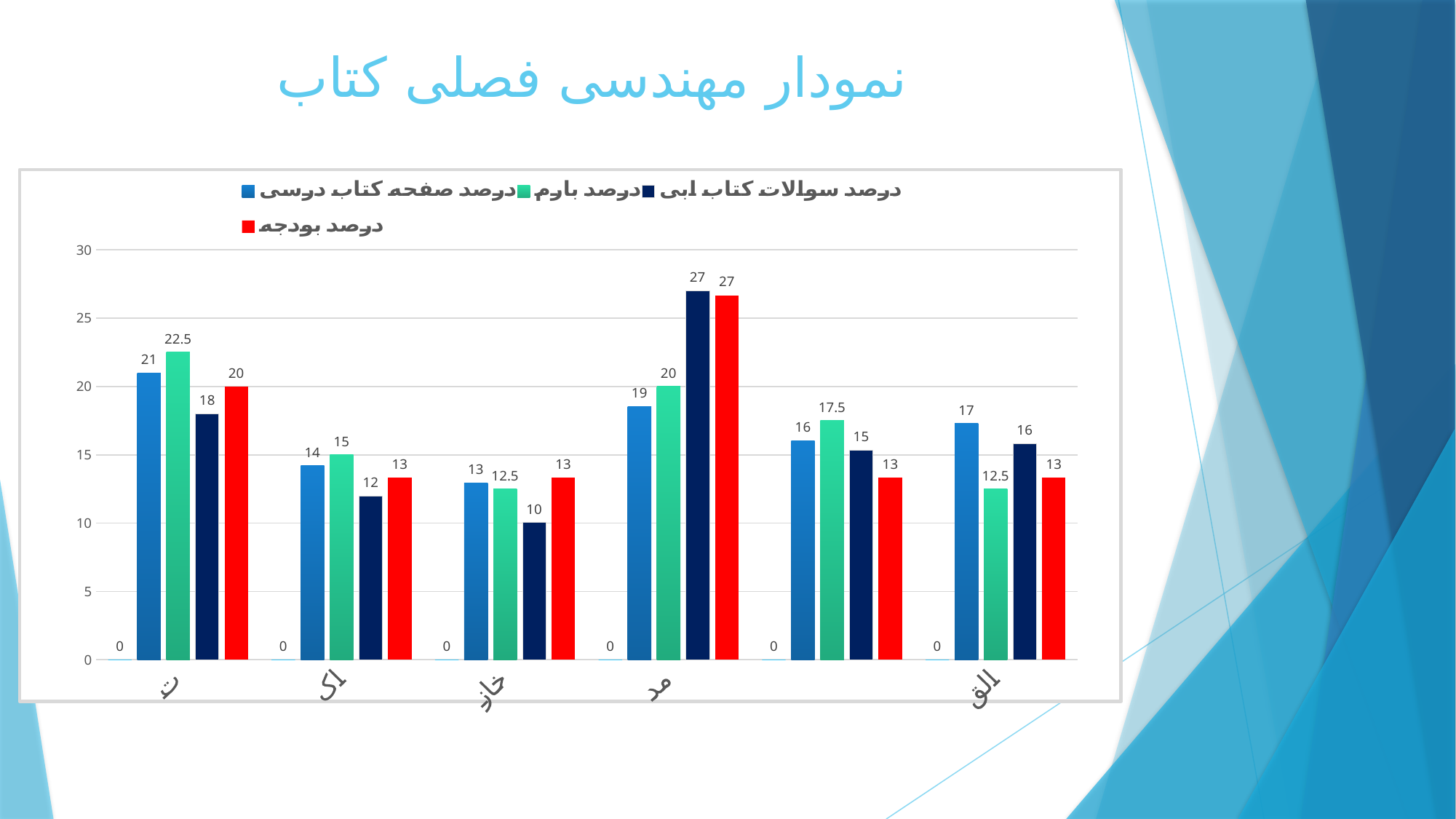
Which group of bars from the left contains the tallest bars in the chart? the fourth group What is the value of the dark navy bar in the rightmost group of bars? 16 What is the lowest non-zero value labelled on a bar in the chart? 10 How many groups of bars (categories) are plotted along the x axis? 6 In the fourth group from the left, how much larger is the dark navy bar than the blue bar? 8 What is the value of the red (درصد بودجه) bar in the fifth group of bars from the left? 13 What kind of chart is shown on the slide? bar chart What is the value of the green bar in the leftmost group of bars? 22.5 In the leftmost group, what is the difference between the blue bar (21) and the dark navy bar (18)? 3 In the second group from the left, which is larger: the green bar or the dark navy bar? the green bar Is the value of the red bar in the fourth group from the left greater or less than 25? greater What is the highest data label shown on any bar in the chart? 27